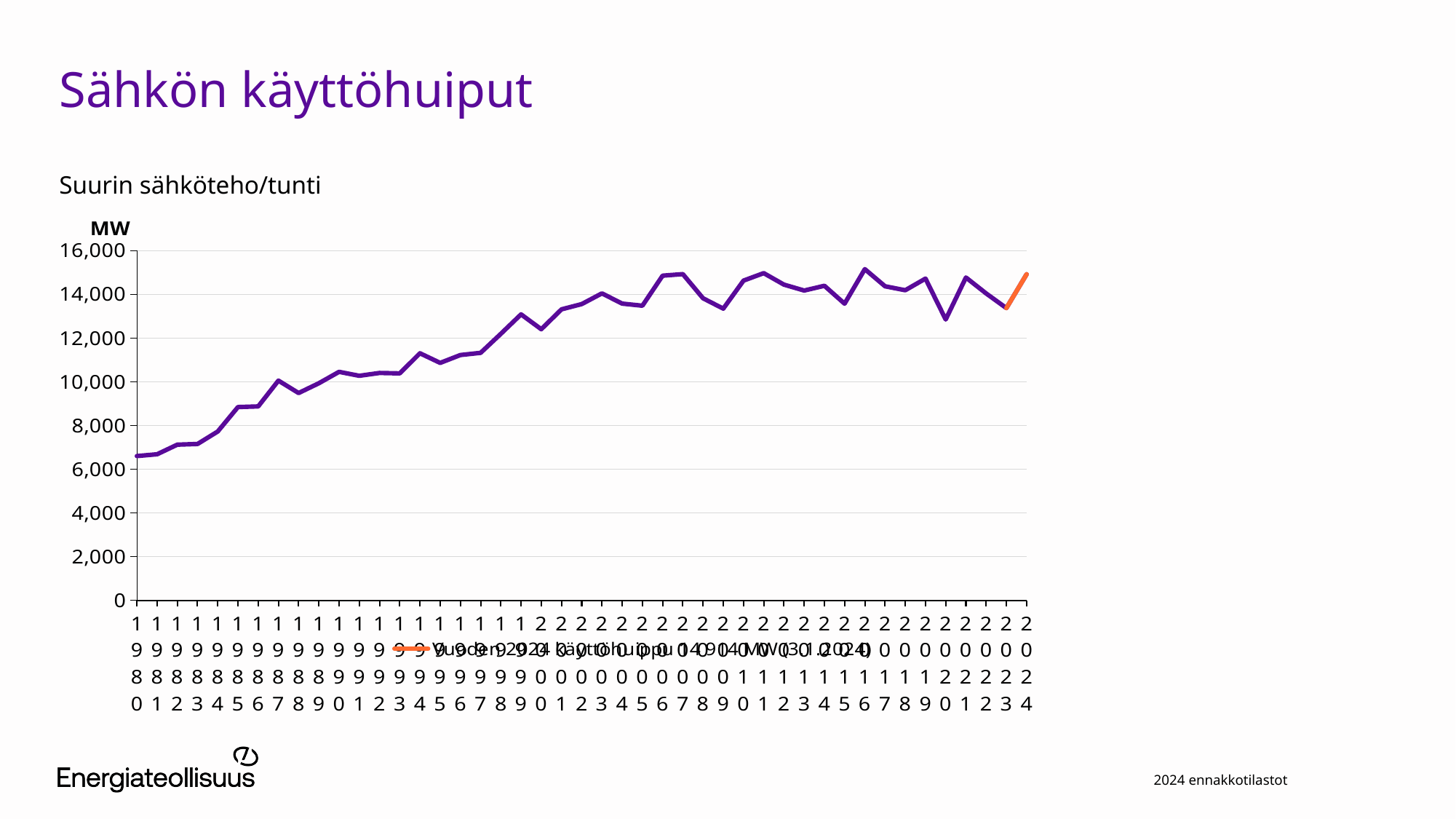
What kind of chart is shown on the slide? line chart Does the plotted value generally rise or fall from 1980 to 2024? rise Is the value for 2020 greater or less than 14,000? less What is the title of the chart? Suurin sähköteho/tunti Is the value for 1980 greater or less than 8,000? less Is the value for 1990 greater or less than 10,000? greater How many years (data points) are plotted along the x axis? 45 Which is larger, the value for 1980 or the value for 2024? 2024 What unit is shown on the y axis of the chart? MW